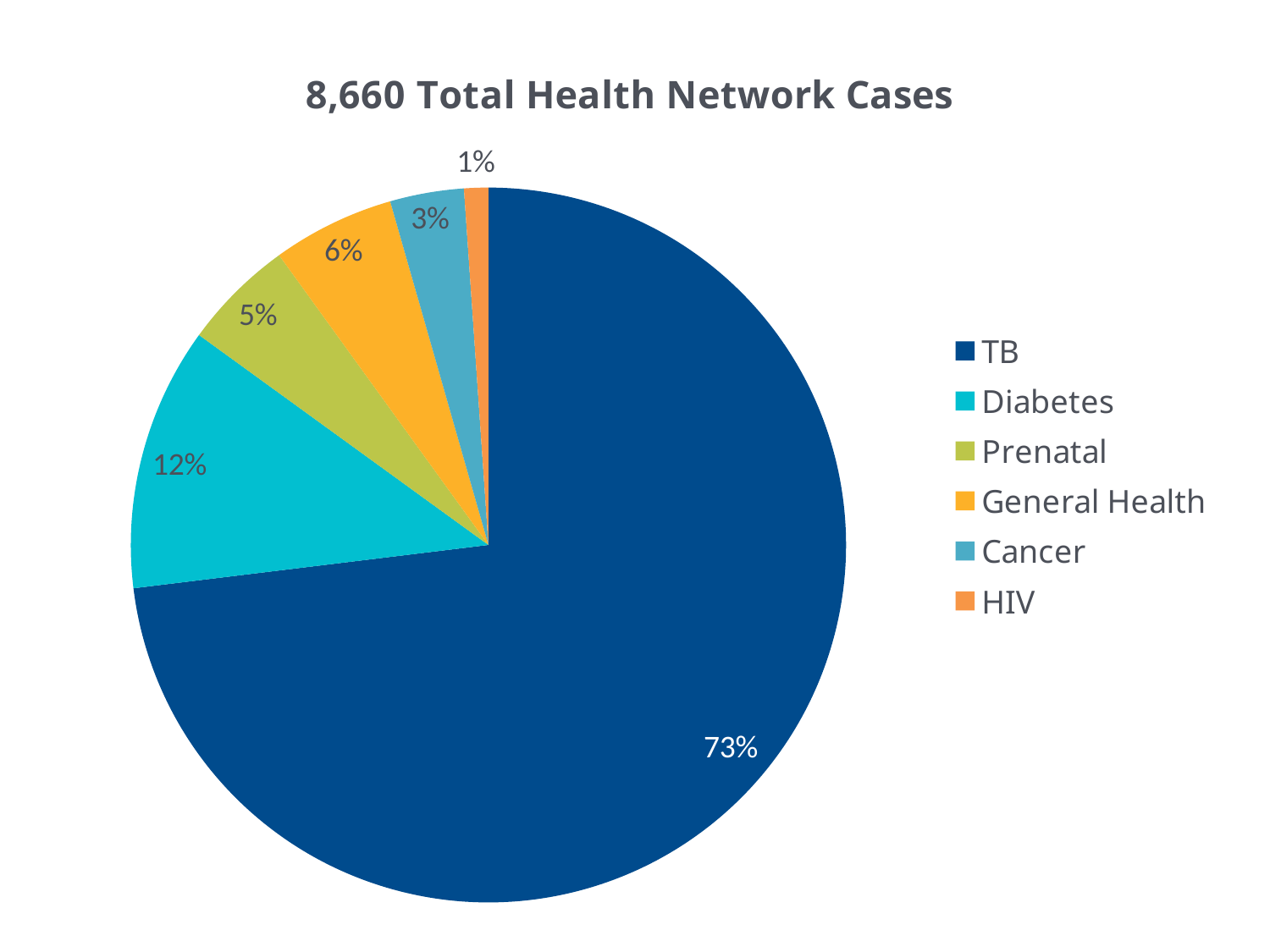
How many categories does the legend list? 6 What share of cases is Prenatal? 5% Which category has the smallest share of cases? HIV What share of cases is TB? 73% What share of cases is Cancer? 3% What is the title of the chart? 8,660 Total Health Network Cases What kind of chart is shown on the slide? pie chart Which category has the largest share of cases? TB What is the difference in percentage points between the TB share and the Diabetes share? 61